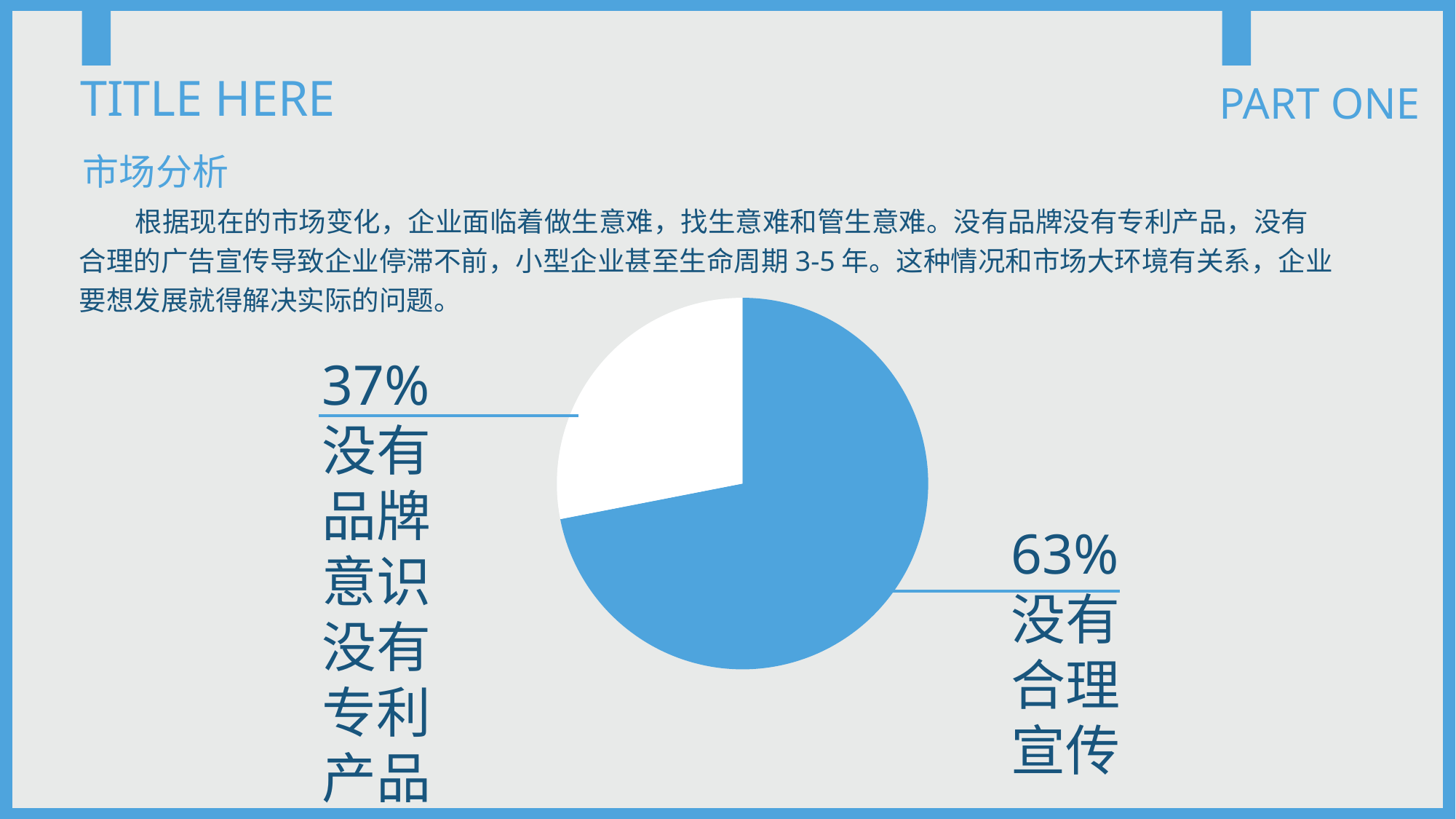
Which slice of the pie chart is the largest? 没有合理宣传 What is the total of the two percentages shown on the pie chart? 100% What colour is the 63% slice of the pie chart? blue What share of the pie is labelled 没有合理宣传? 63% What share of the pie is labelled 没有品牌意识没有专利产品? 37% What kind of chart is shown on the slide? pie chart What colour is the 37% slice of the pie chart? white Which is larger: the 没有合理宣传 slice or the 没有品牌意识没有专利产品 slice? 没有合理宣传 Which slice of the pie chart is the smallest? 没有品牌意识没有专利产品 How many slices does the pie chart have? 2 What is the difference in percentage points between the 没有合理宣传 slice and the 没有品牌意识没有专利产品 slice? 26